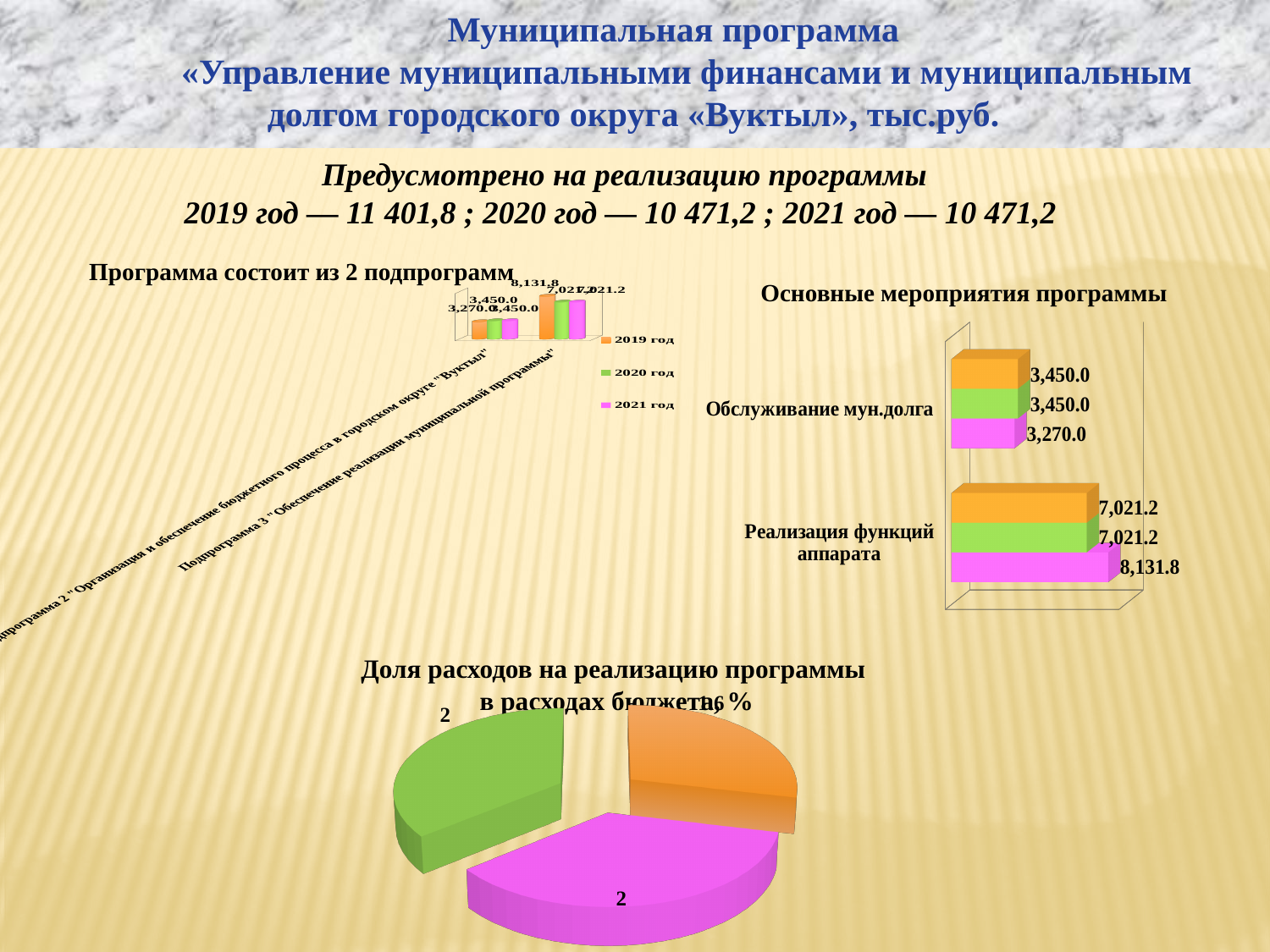
How many categories does the "Основные мероприятия программы" chart show? 2 What kind of chart is the "Основные мероприятия программы" chart? bar chart How many slices does the "Доля расходов на реализацию программы в расходах бюджета, %" pie chart have? 3 In the "Основные мероприятия программы" chart, what is the difference between the largest and smallest values for "Реализация функций аппарата"? 1,110.6 In the "Основные мероприятия программы" chart, what is the largest value shown for "Реализация функций аппарата"? 8,131.8 What kind of chart is the "Доля расходов на реализацию программы в расходах бюджета, %" chart? pie chart In the "Основные мероприятия программы" chart, what is the difference between the largest and smallest values for "Обслуживание мун.долга"? 180.0 How many series does the legend of the top-left chart ("Программа состоит из 2 подпрограмм") list? 3 What are the legend entries of the top-left chart ("Программа состоит из 2 подпрограмм")? 2019 год, 2020 год, 2021 год In the "Основные мероприятия программы" chart, what is the smallest value shown for "Обслуживание мун.долга"? 3,270.0 In the "Основные мероприятия программы" chart, what is the value of the pink bar for "Обслуживание мун.долга"? 3,270.0 In the "Основные мероприятия программы" chart, which category has the larger values: "Обслуживание мун.долга" or "Реализация функций аппарата"? Реализация функций аппарата